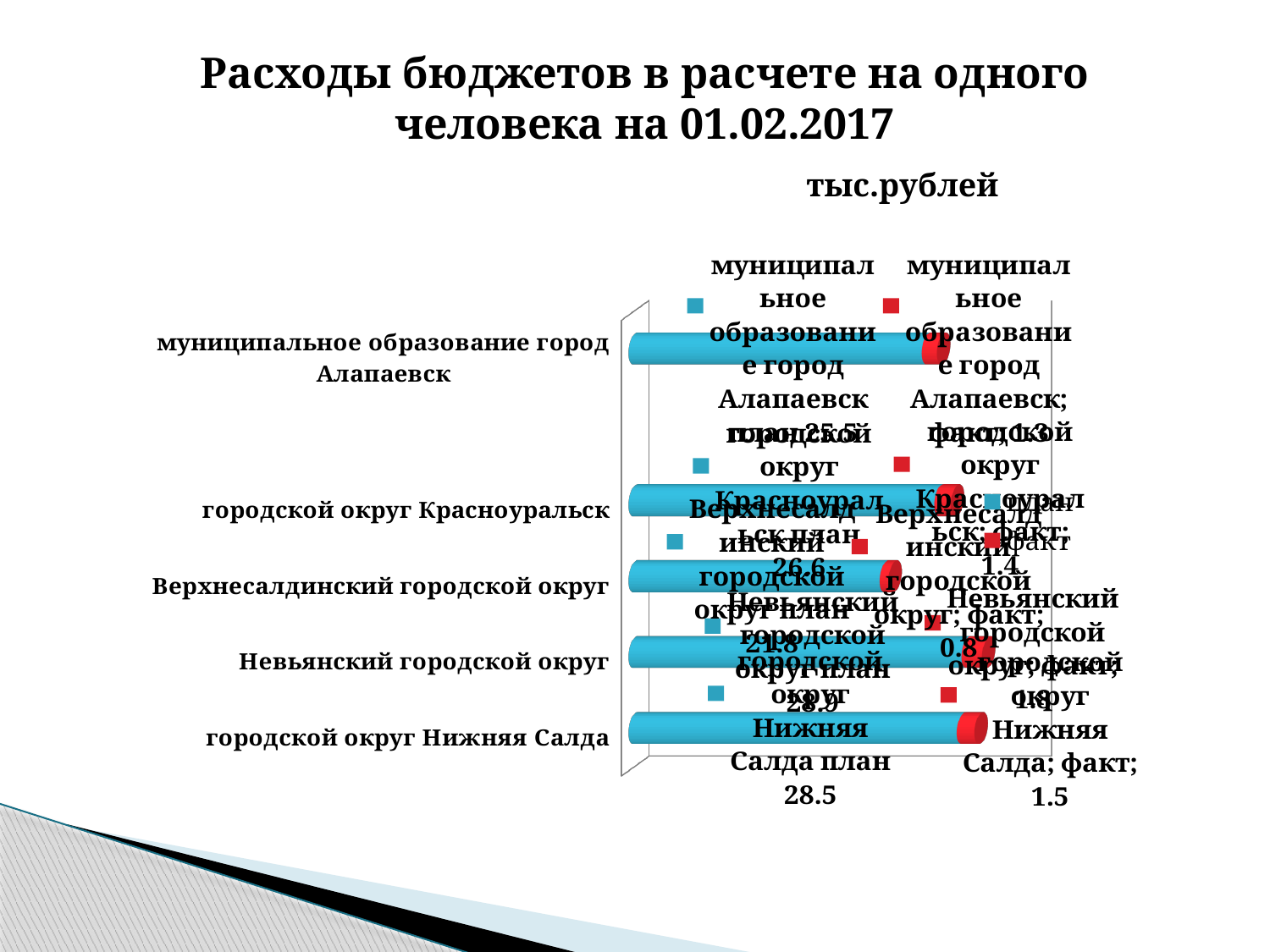
What is the факт value for городской округ Красноуральск? 1.4 What kind of chart is shown on the slide? bar chart How many series does the chart show for each municipality? 2 What is the факт value for Верхнесалдинский городской округ? 0.8 What is the difference between the план values of городской округ Нижняя Салда and Верхнесалдинский городской округ? 6.7 What is the план value for городской округ Нижняя Салда? 28.5 What is the факт value for городской округ Нижняя Салда? 1.5 What is the план value for Верхнесалдинский городской округ? 21.8 In what units are the values on the chart expressed? тыс.рублей What is the план value for городской округ Красноуральск? 26.6 How many municipalities (categories) are plotted on the chart? 5 Which municipality has the lowest план value? Верхнесалдинский городской округ